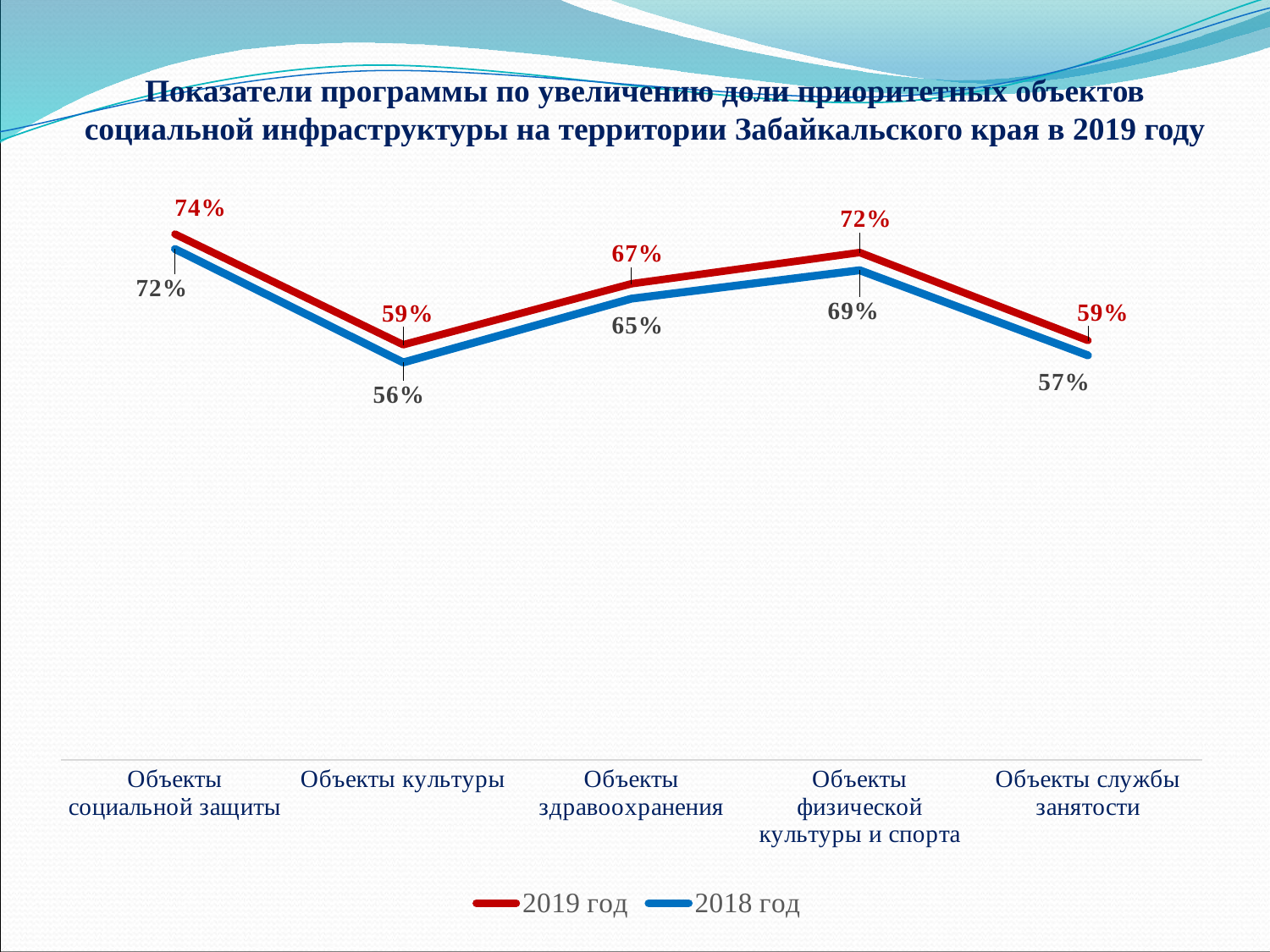
How many categories are shown on the x axis? 5 What is the 2019 год value for Объекты социальной защиты? 74% What is the difference between the 2019 год and 2018 год values for Объекты физической культуры и спорта? 3% What kind of chart is this? Line chart What is the 2019 год value for Объекты здравоохранения? 67% Which category has the lowest 2018 год value? Объекты культуры Which is larger: the 2019 год value for Объекты здравоохранения or the 2019 год value for Объекты службы занятости? Объекты здравоохранения What is the 2018 год value for Объекты культуры? 56% Which colour is used for the 2018 год series? Blue How many series does the legend list? 2 What is the 2018 год value for Объекты службы занятости? 57% Which category has the highest 2019 год value? Объекты социальной защиты